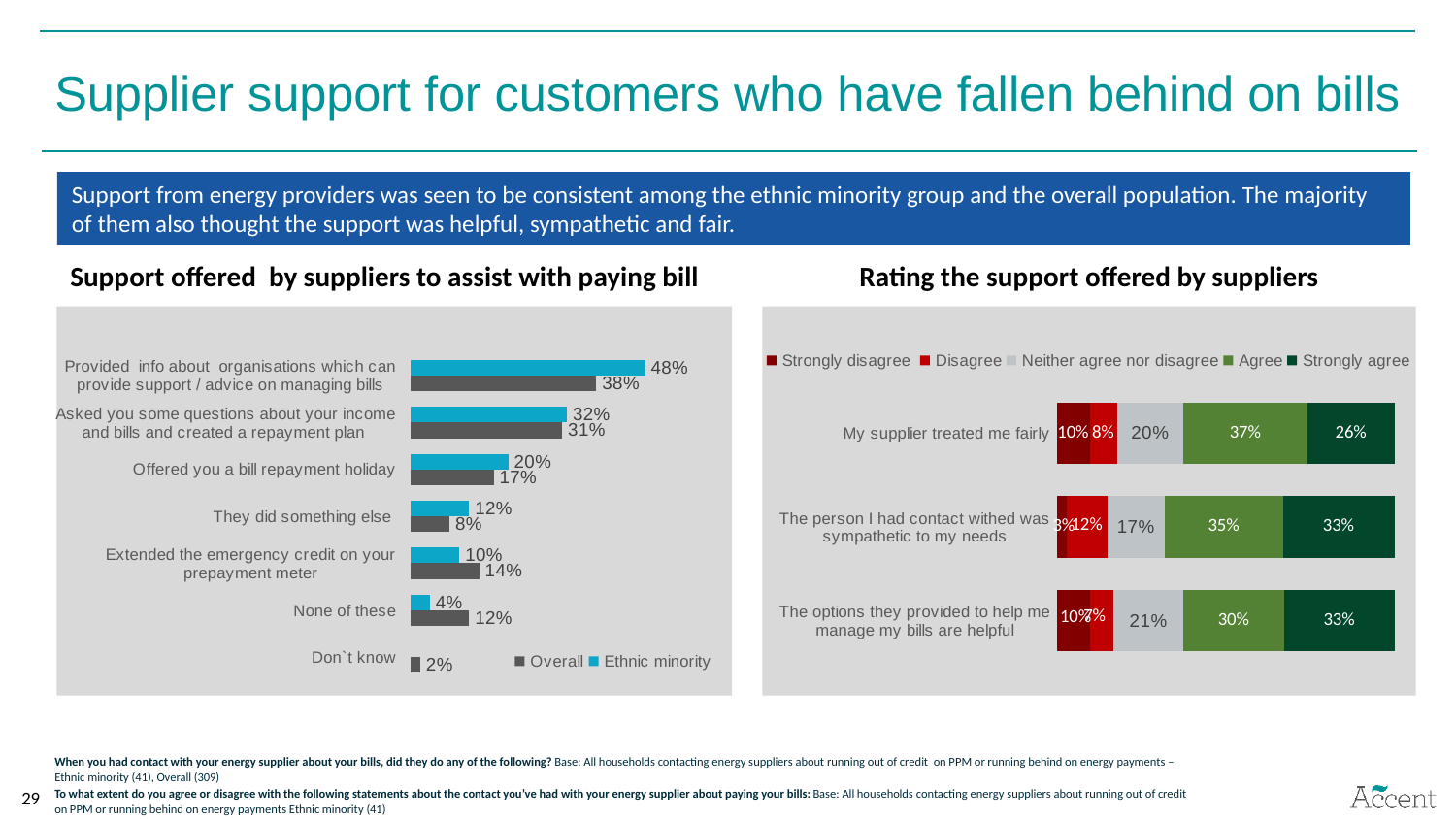
What type of chart is 'Support offered by suppliers to assist with paying bill'? Bar chart In the 'Rating the support offered by suppliers' chart, what percentage strongly agree that 'My supplier treated me fairly'? 26% In the 'Support offered by suppliers to assist with paying bill' chart, what percentage of the Ethnic minority group said the supplier provided info about organisations which can provide support / advice on managing bills? 48% In the 'Rating the support offered by suppliers' chart, how many series does the legend list? 5 In the 'Rating the support offered by suppliers' chart, how many statements are rated? 3 In the 'Rating the support offered by suppliers' chart, which statement has the highest 'Agree' percentage? My supplier treated me fairly In the 'Support offered by suppliers to assist with paying bill' chart, which category has the highest Ethnic minority value? Provided info about organisations which can provide support / advice on managing bills In the 'Support offered by suppliers to assist with paying bill' chart, how many series does the legend list? 2 In the 'Support offered by suppliers to assist with paying bill' chart, what is the difference between the Ethnic minority and Overall values for 'Provided info about organisations which can provide support / advice on managing bills'? 10 percentage points In the 'Support offered by suppliers to assist with paying bill' chart, for 'None of these', which is larger: the Overall value or the Ethnic minority value? Overall In the 'Rating the support offered by suppliers' chart, what percentage neither agree nor disagree that 'The options they provided to help me manage my bills are helpful'? 21% In the 'Support offered by suppliers to assist with paying bill' chart, what is the Overall value for 'Extended the emergency credit on your prepayment meter'? 14%